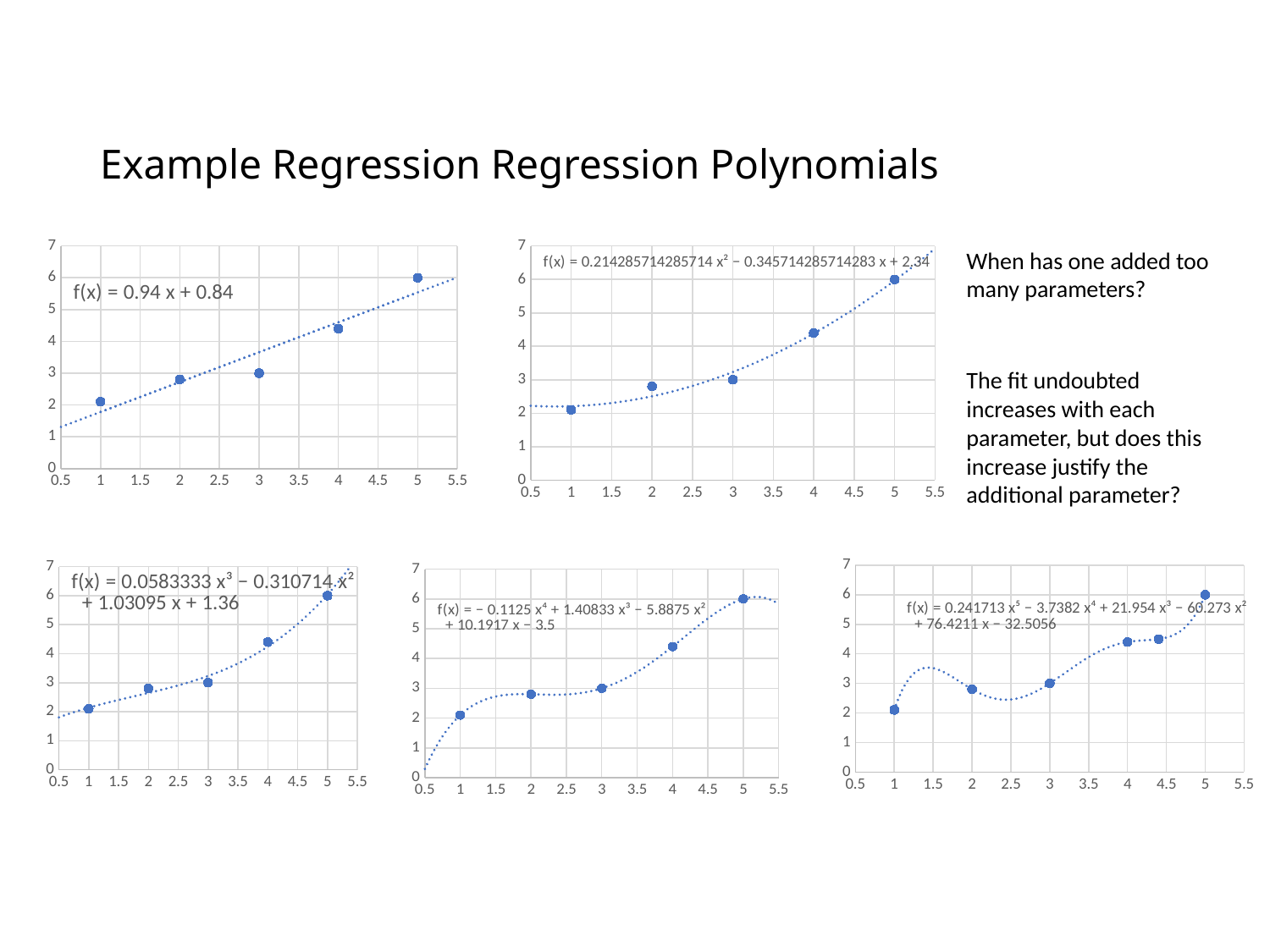
In the bottom-middle chart, is the value at x = 4 greater or less than 4? greater What kind of chart is the top-left chart? scatter chart In the top-left chart, at which x value is the plotted point highest? 5 In the top-right chart, at which x value is the plotted point lowest? 1 In the bottom-left chart, do the plotted points rise or fall as x increases? rise In the top-right chart, is the value at x = 1 greater or less than 3? less In the top-left chart, is the value at x = 5 greater or less than 5? greater In the bottom-left chart, what is the coefficient of x³ in the fitted equation? 0.0583333 In the top-left chart, what is the fitted equation shown? f(x) = 0.94 x + 0.84 How many data points are plotted in the bottom-right chart? 6 In the bottom-right chart, is the point at x = 5 higher or lower than the point at x = 1? higher How many data points are plotted in the top-left chart? 5